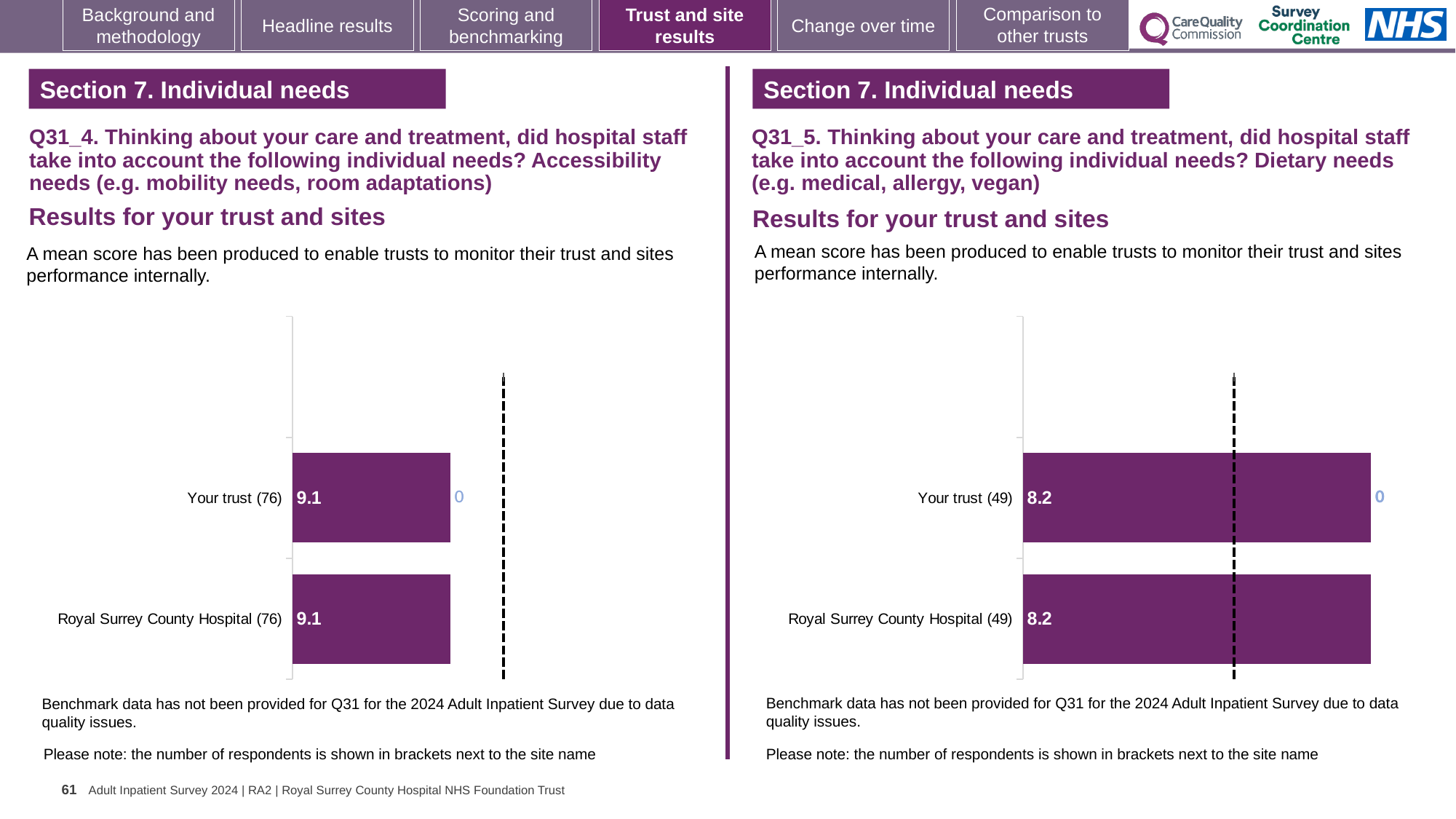
On the right chart (Q31_5, dietary needs), what is the mean score for Your trust? 8.2 How many bars are plotted on the left chart (Q31_4)? 2 On the left chart (Q31_4, accessibility needs), what is the mean score for Your trust? 9.1 On the left chart (Q31_4), how many respondents are shown in brackets next to Your trust? 76 On the left chart (Q31_4, accessibility needs), what is the mean score for Royal Surrey County Hospital? 9.1 On the right chart (Q31_5, dietary needs), what is the mean score for Royal Surrey County Hospital? 8.2 What type of chart is used on the left (Q31_4)? Bar chart Which is larger: the Your trust score on the left chart (Q31_4) or the Your trust score on the right chart (Q31_5)? Left chart (Q31_4), 9.1 What is the difference between the Your trust score on the left chart (Q31_4) and the Your trust score on the right chart (Q31_5)? 0.9 On the left chart (Q31_4), what is the difference between the Your trust score and the Royal Surrey County Hospital score? 0 How many bars are plotted on the right chart (Q31_5)? 2 On the right chart (Q31_5), how many respondents are shown in brackets next to Royal Surrey County Hospital? 49